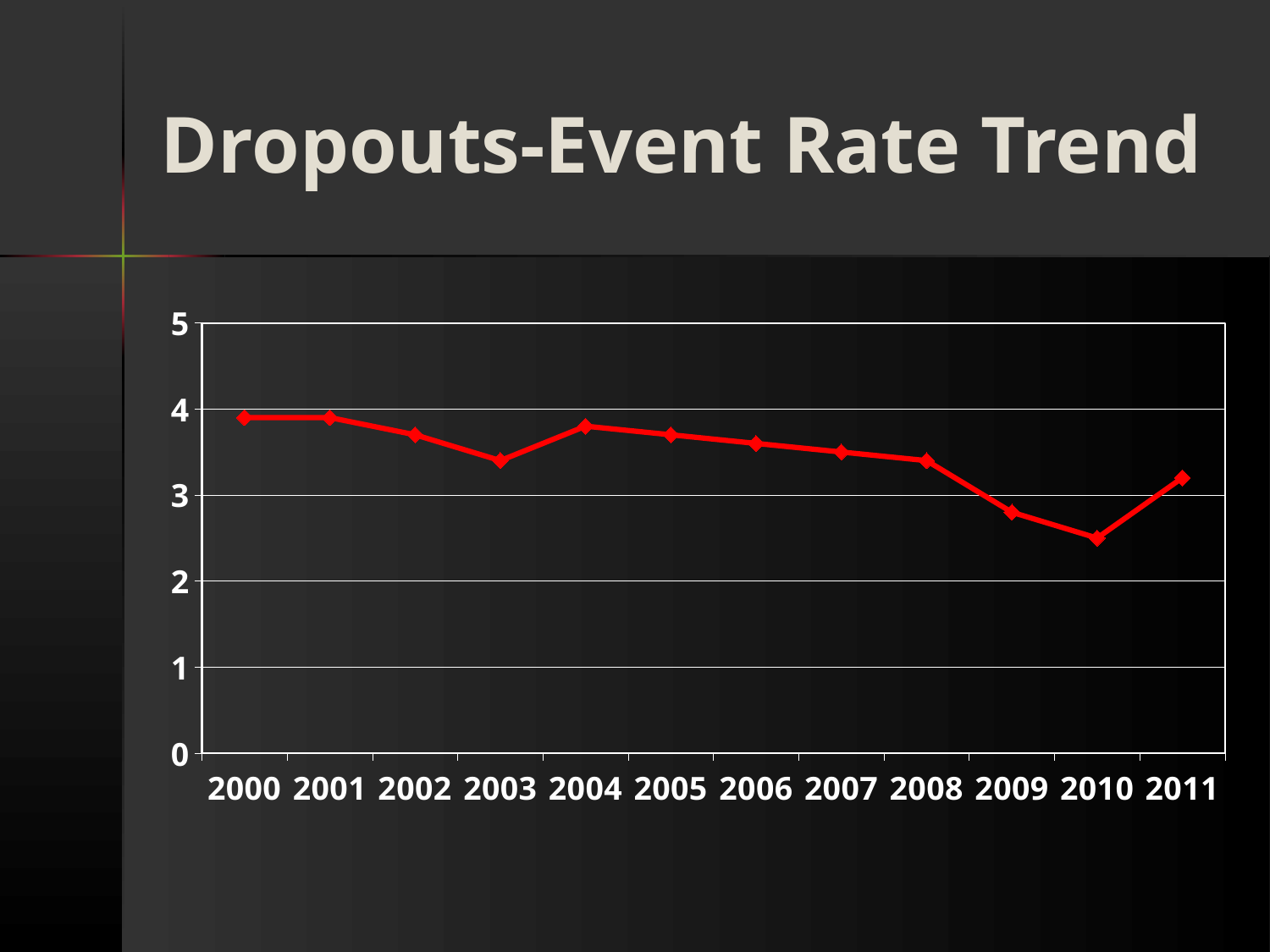
Is the value for 2010 greater or less than 3? less How many years are plotted on the x axis? 12 Which year has the lowest value? 2010 Which is larger, the value for 2009 or the value for 2011? 2011 What kind of chart is shown on the slide? line chart Is the value for 2000 greater or less than 3? greater Do the values generally rise or fall from 2000 to 2010? fall What is the title of the chart? Dropouts-Event Rate Trend Is the value for 2011 greater or less than 3? greater Which is larger, the value for 2003 or the value for 2004? 2004